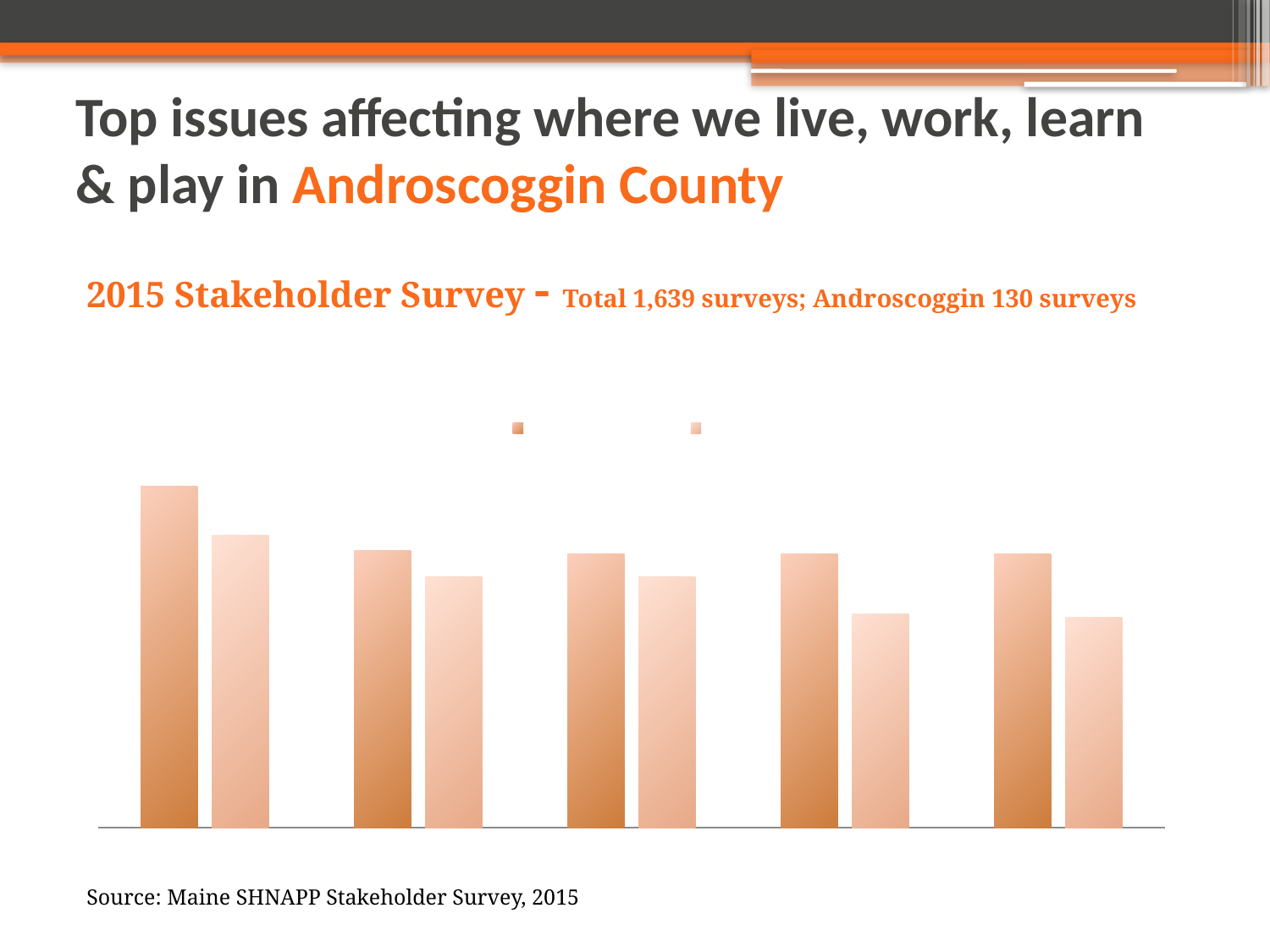
Is the darker orange bar in the first group taller or shorter than the darker orange bar in the second group? taller How many series does the chart's legend list? 2 Which group of bars contains the shortest bar on the chart? the rightmost (fifth) group What kind of chart is shown on the slide? bar chart How many groups of bars (categories) does the chart show? 5 Which county is named in the slide title? Androscoggin County Is the lighter orange bar in the first group taller or shorter than the lighter orange bar in the fifth group? taller According to the slide, how many surveys were completed in Androscoggin? 130 surveys In the leftmost group of bars, is the darker orange bar or the lighter orange bar taller? the darker orange bar Which group of bars contains the tallest bar on the chart? the leftmost group